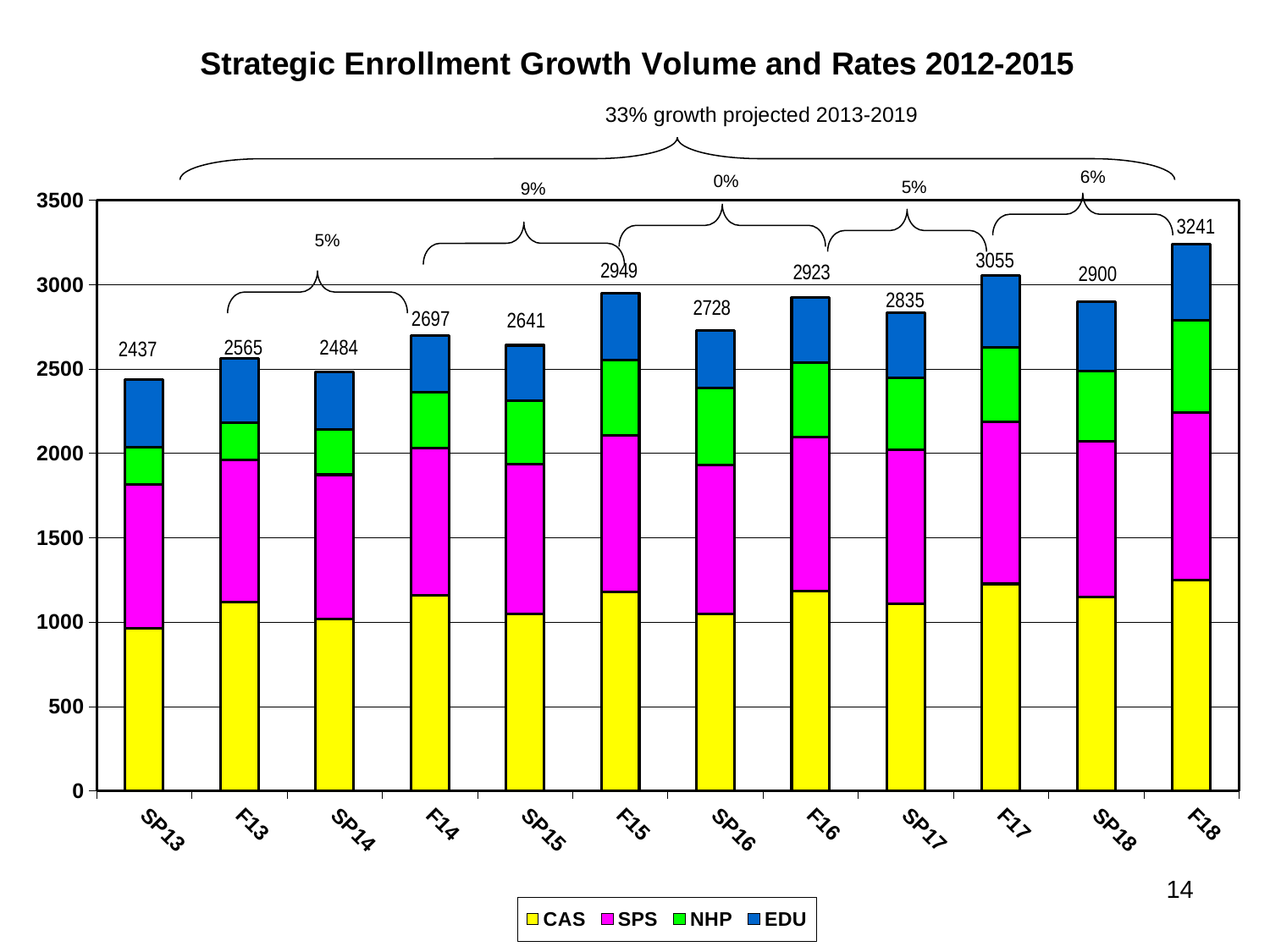
What is the title of the chart? Strategic Enrollment Growth Volume and Rates 2012-2015 Which term has the lowest total enrollment? SP13 How many series does the legend list? 4 Which has a larger total enrollment, F16 or F17? F17 Do the total enrollment values generally rise or fall from SP13 to F18? Rise What kind of chart is shown on the slide? Stacked bar chart What is the difference between the total for F18 and the total for SP13? 804 Is the CAS value for SP13 greater or less than 1000? less What is the total enrollment shown for F15? 2949 Which term has the highest total enrollment? F18 How many terms are shown on the x axis? 12 What is the total enrollment shown for SP17? 2835